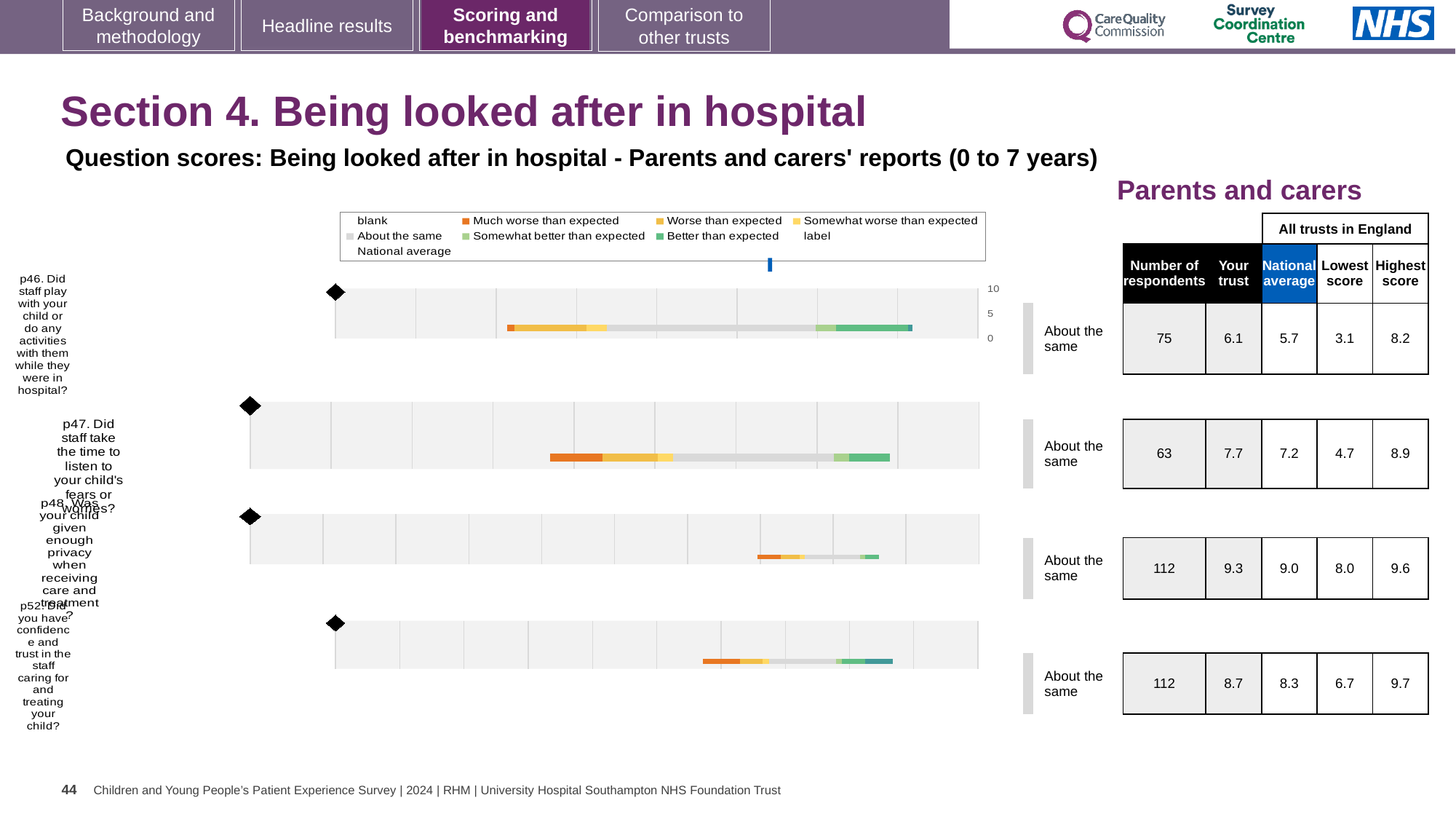
How many respondents answered question p46? 75 Which question has the highest 'Your trust' score? p48 What is the difference between the 'Your trust' score and the national average for question p47? 0.5 What kind of chart is used to show the question scores on this slide? bar chart How many questions (charts) are shown on the slide? 4 Which question has the lowest 'Your trust' score? p46 What is the highest score among all trusts in England for question p48 (Was your child given enough privacy when receiving care and treatment?)? 9.6 For question p52, which is larger: the 'Your trust' score or the national average? Your trust What is the lowest score among all trusts in England for question p52 (Did you have confidence and trust in the staff caring for and treating your child?)? 6.7 What benchmark category is shown for all four questions on this slide? About the same What is the national average score for question p47 (Did staff take the time to listen to your child's fears or worries?)? 7.2 What is the 'Your trust' score for question p46 (Did staff play with your child or do any activities with them while they were in hospital?)? 6.1